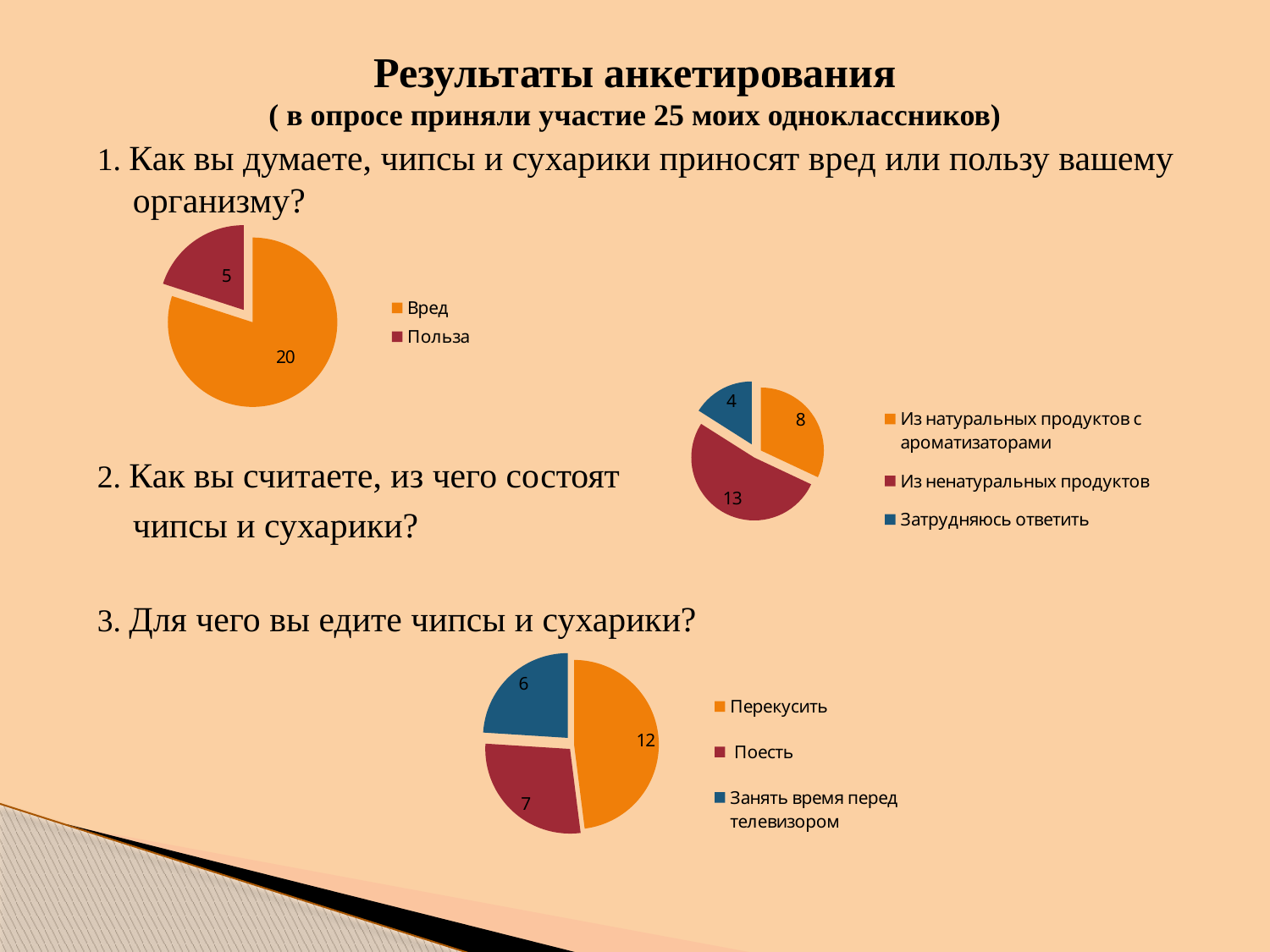
In the pie chart for question 3 (bottom), what is the value for Перекусить? 12 In the pie chart for question 2 (middle-right), which category has the lowest value? Затрудняюсь ответить In the pie chart for question 1 (top-left), what is the difference between Вред and Польза? 15 In the pie chart for question 2 (middle-right), which is larger: Из натуральных продуктов с ароматизаторами or Из ненатуральных продуктов? Из ненатуральных продуктов In the pie chart for question 1 (top-left), what is the value for Польза? 5 What type of chart is used for question 3 (bottom)? Pie chart In the pie chart for question 2 (middle-right), what is the value for Из ненатуральных продуктов? 13 In the pie chart for question 3 (bottom), which category has the highest value? Перекусить In the pie chart for question 1 (top-left), what is the value for Вред? 20 In the pie chart for question 1 (top-left), what share of the pie does Вред represent? 80% In the pie chart for question 3 (bottom), what is the difference between Поесть and Занять время перед телевизором? 1 In the pie chart for question 2 (middle-right), how many categories are shown? 3